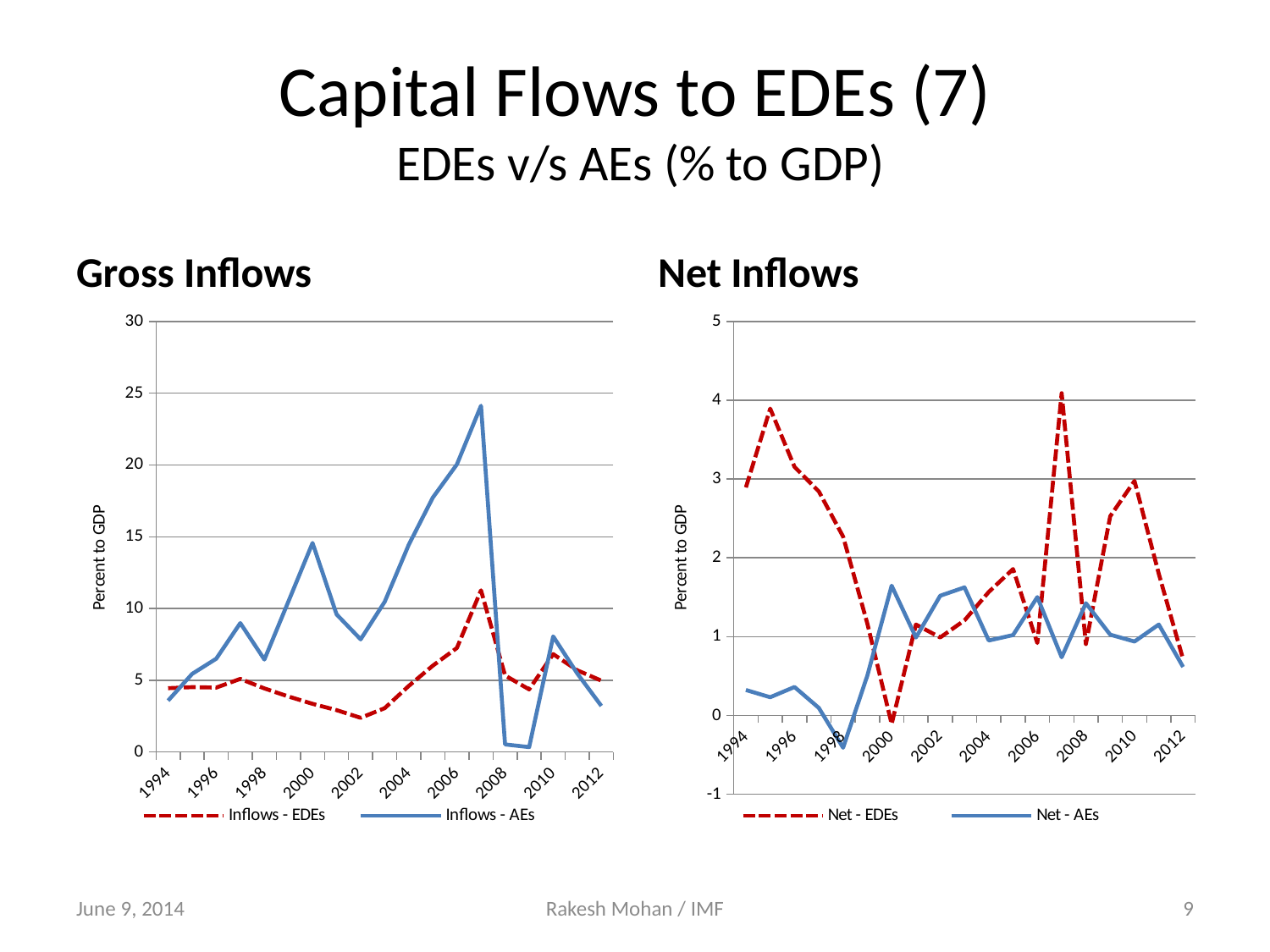
In the Net Inflows chart, which year has the highest value for Net - EDEs? 2007 In the Net Inflows chart, which series is larger in 2007, Net - EDEs or Net - AEs? Net - EDEs In the Gross Inflows chart, which year has the highest value for Inflows - AEs? 2007 In the Net Inflows chart, is the value for Net - EDEs in 1995 greater or less than 3? greater In the Gross Inflows chart, is the value for Inflows - AEs in 2007 greater or less than 20? greater In the Net Inflows chart, is the value for Net - AEs in 1998 greater or less than 0? less How many series does the legend of the Net Inflows chart list? 2 What kind of chart is the Gross Inflows chart? line chart What is the y-axis label of the Gross Inflows chart? Percent to GDP In the Gross Inflows chart, which series is larger in 2007, Inflows - EDEs or Inflows - AEs? Inflows - AEs In the Gross Inflows chart, which year has the lowest value for Inflows - AEs? 2009